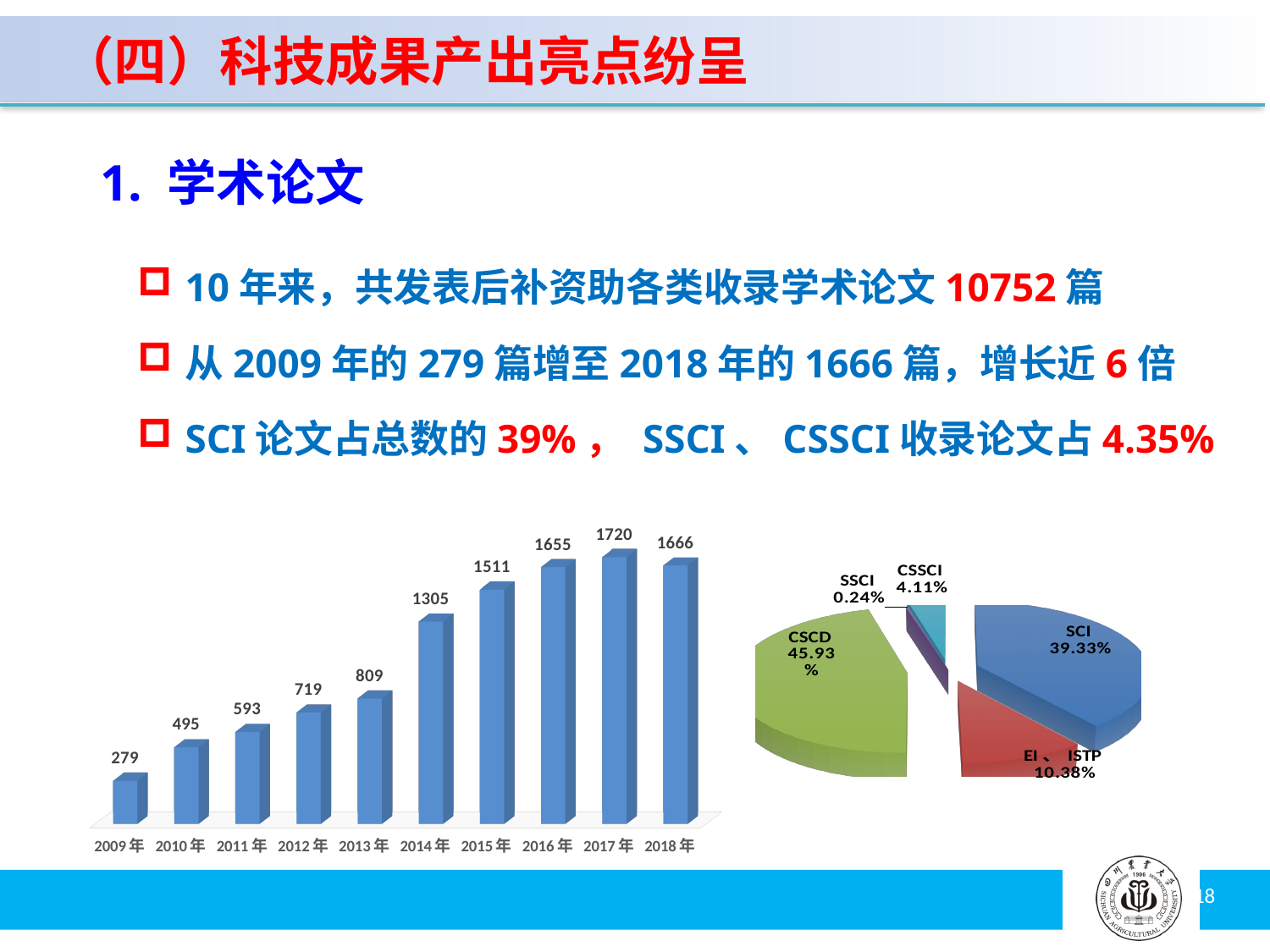
How many years are shown in the bar chart on the left? 10 In the bar chart on the left, which year has the highest value? 2017年 In the pie chart on the right, which category has the smallest share? SSCI What kind of chart is the chart on the left? bar chart In the bar chart on the left, do the values generally rise or fall from 2009年 to 2017年? rise In the bar chart on the left, which is larger, the value for 2017年 or the value for 2018年? 2017年 In the bar chart on the left, what is the difference between the values for 2018年 and 2009年? 1387 In the bar chart on the left, what is the value for 2014年? 1305 In the pie chart on the right, which category has the largest share? CSCD In the bar chart on the left, what is the value for 2009年? 279 In the bar chart on the left, which year has the lowest value? 2009年 In the pie chart on the right, what share does SCI have? 39.33%